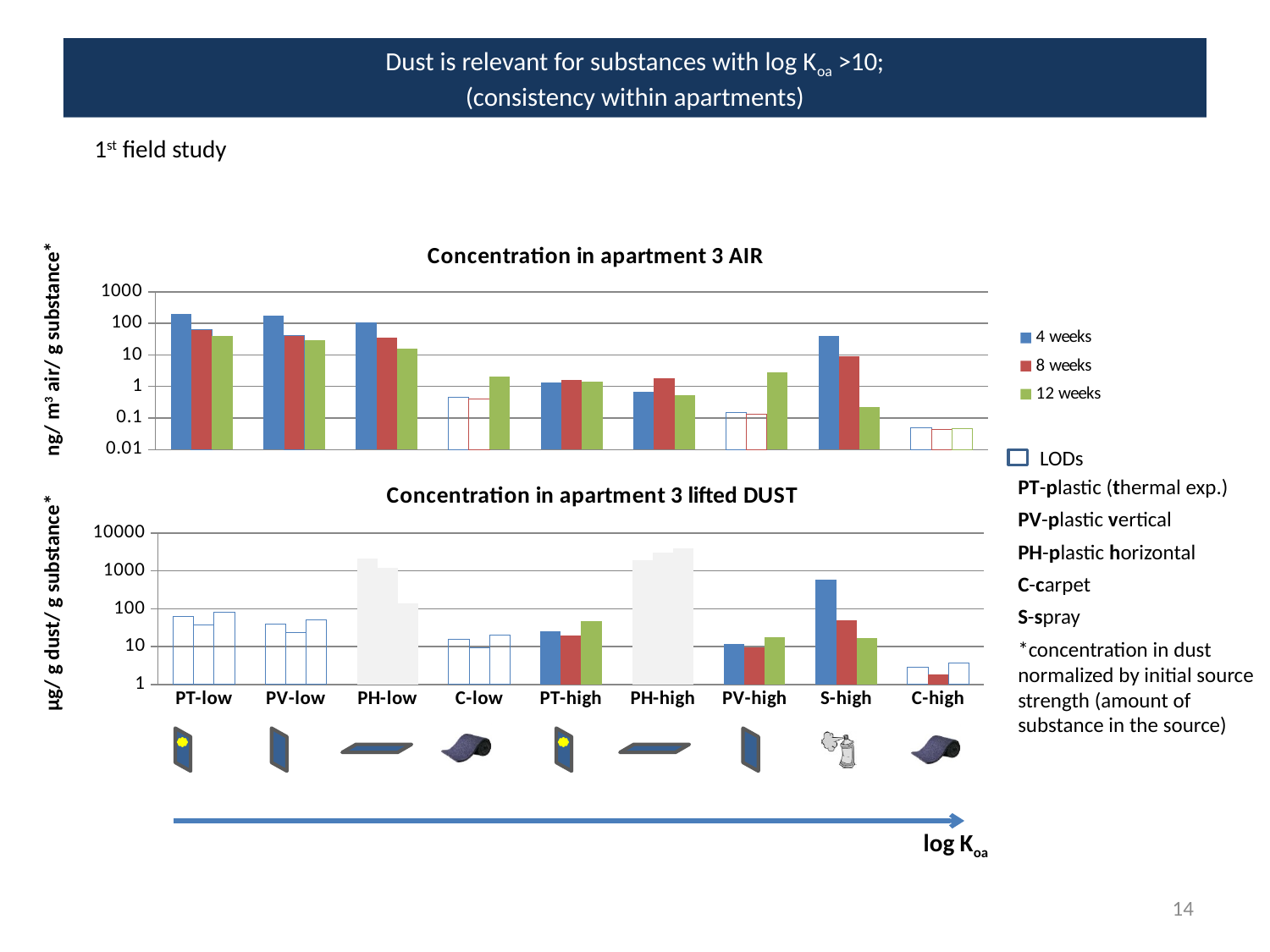
In the 'Concentration in apartment 3 AIR' chart, which is larger for 4 weeks: PT-low or S-high? PT-low What type of chart is the 'Concentration in apartment 3 AIR' chart? bar chart How many categories are shown on the x axis of the 'Concentration in apartment 3 lifted DUST' chart? 9 In the 'Concentration in apartment 3 AIR' chart, is the 4 weeks value for PT-low greater or less than 100? greater In the 'Concentration in apartment 3 AIR' chart, is the 12 weeks value for S-high greater or less than 1? less What is the y-axis label of the 'Concentration in apartment 3 AIR' chart? ng/ m³ air/ g substance* In the 'Concentration in apartment 3 AIR' chart, do the values for S-high rise or fall from 4 weeks to 12 weeks? fall In the 'Concentration in apartment 3 lifted DUST' chart, is the 8 weeks value for C-high greater or less than 10? less How many series does the legend list for the 'Concentration in apartment 3 AIR' chart? 3 In the 'Concentration in apartment 3 lifted DUST' chart, which is larger for 4 weeks: S-high or PT-high? S-high